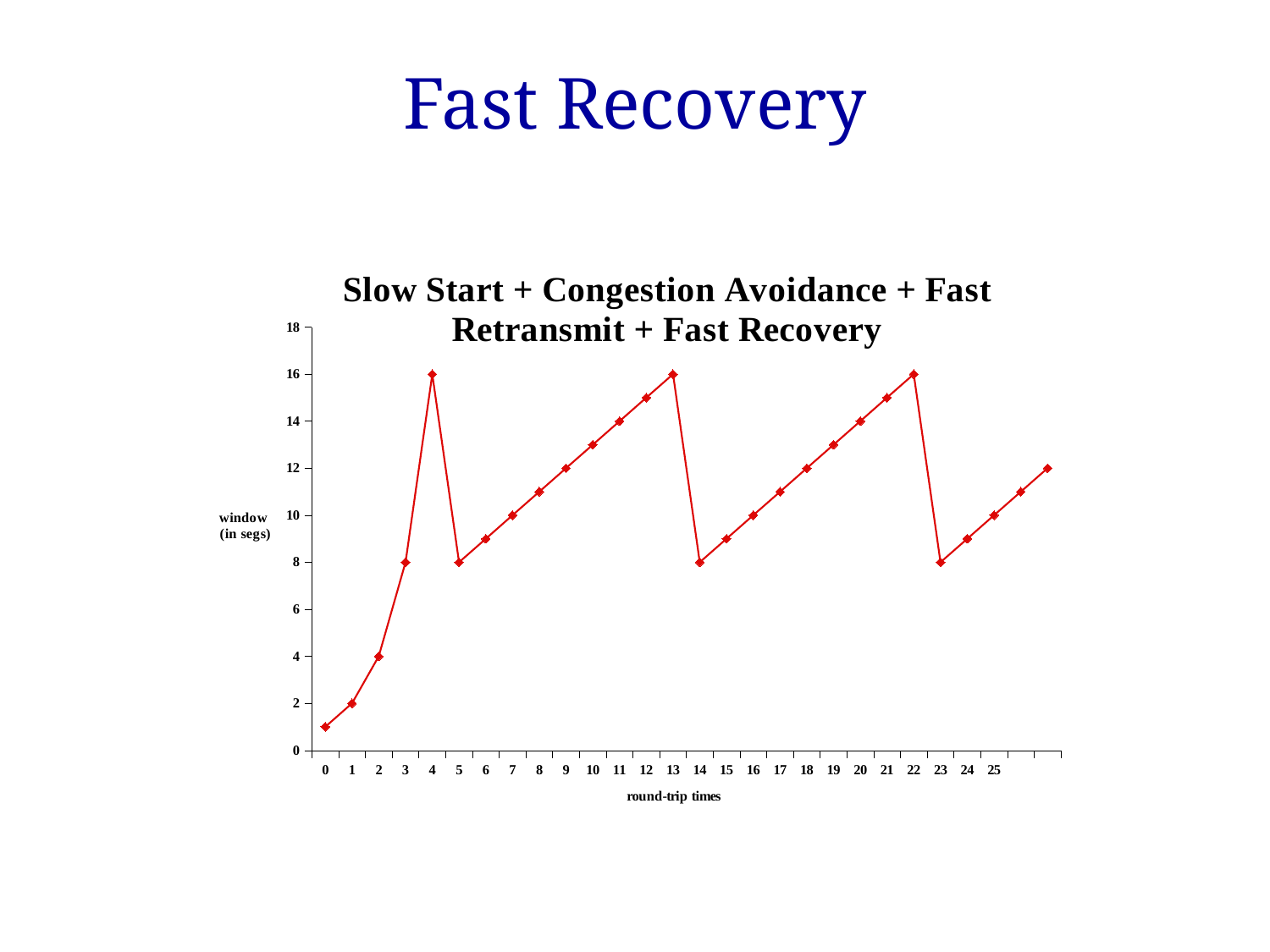
What is the window size (in segs) at round-trip time 25? 10 What is the chart's title? Slow Start + Congestion Avoidance + Fast Retransmit + Fast Recovery What is the highest window size reached on the chart? 16 Which is larger, the window size at round-trip time 13 or at round-trip time 14? round-trip time 13 Does the window size rise or fall between round-trip times 5 and 13? rise What is the window size (in segs) at round-trip time 5? 8 Is the window size at round-trip time 0 greater or less than 2? less What is the difference between the window size at round-trip time 22 and at round-trip time 23? 8 What kind of chart is shown on the slide? line chart What is the window size (in segs) at round-trip time 2? 4 What is the window size (in segs) at round-trip time 4? 16 Is the window size at round-trip time 12 greater or less than 14? greater